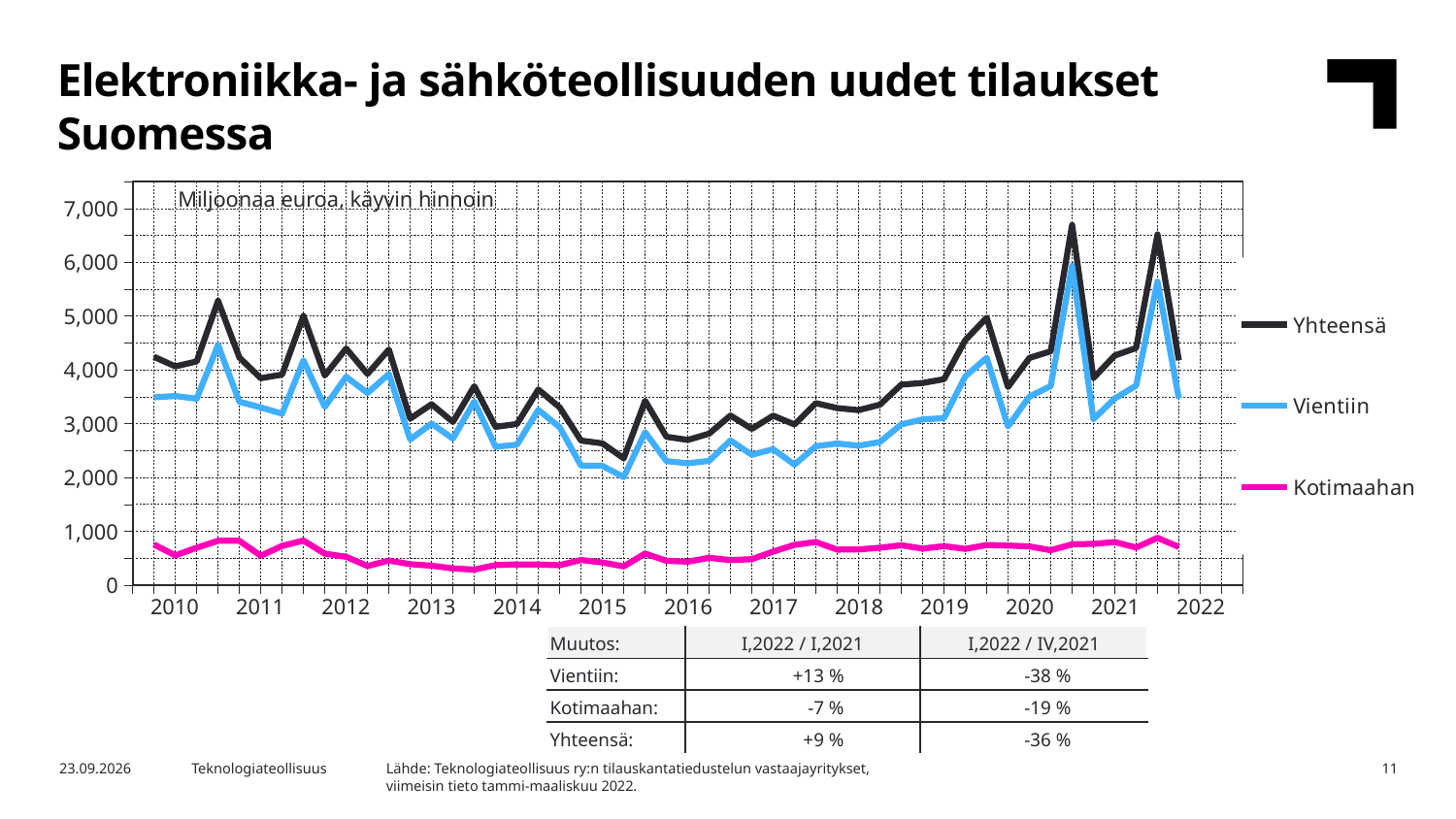
Which is larger in 2019, the value for Vientiin or the value for Kotimaahan? Vientiin Which series has the lowest values throughout the chart? Kotimaahan How many year labels are shown on the x axis? 13 Is the value for Vientiin at the start of 2015 greater or less than 3,000? less How many series does the chart's legend list? 3 Does the Yhteensä series generally rise or fall between 2010 and 2015? fall Which series are listed in the chart's legend? Yhteensä, Vientiin, Kotimaahan What kind of chart is shown on the slide? line chart Is the value for Kotimaahan in 2010 greater or less than 1,000? less What unit is stated inside the chart area? Miljoonaa euroa, käyvin hinnoin Is the peak value for Yhteensä in 2020 greater or less than 6,000? greater Which series has the highest values throughout the chart? Yhteensä